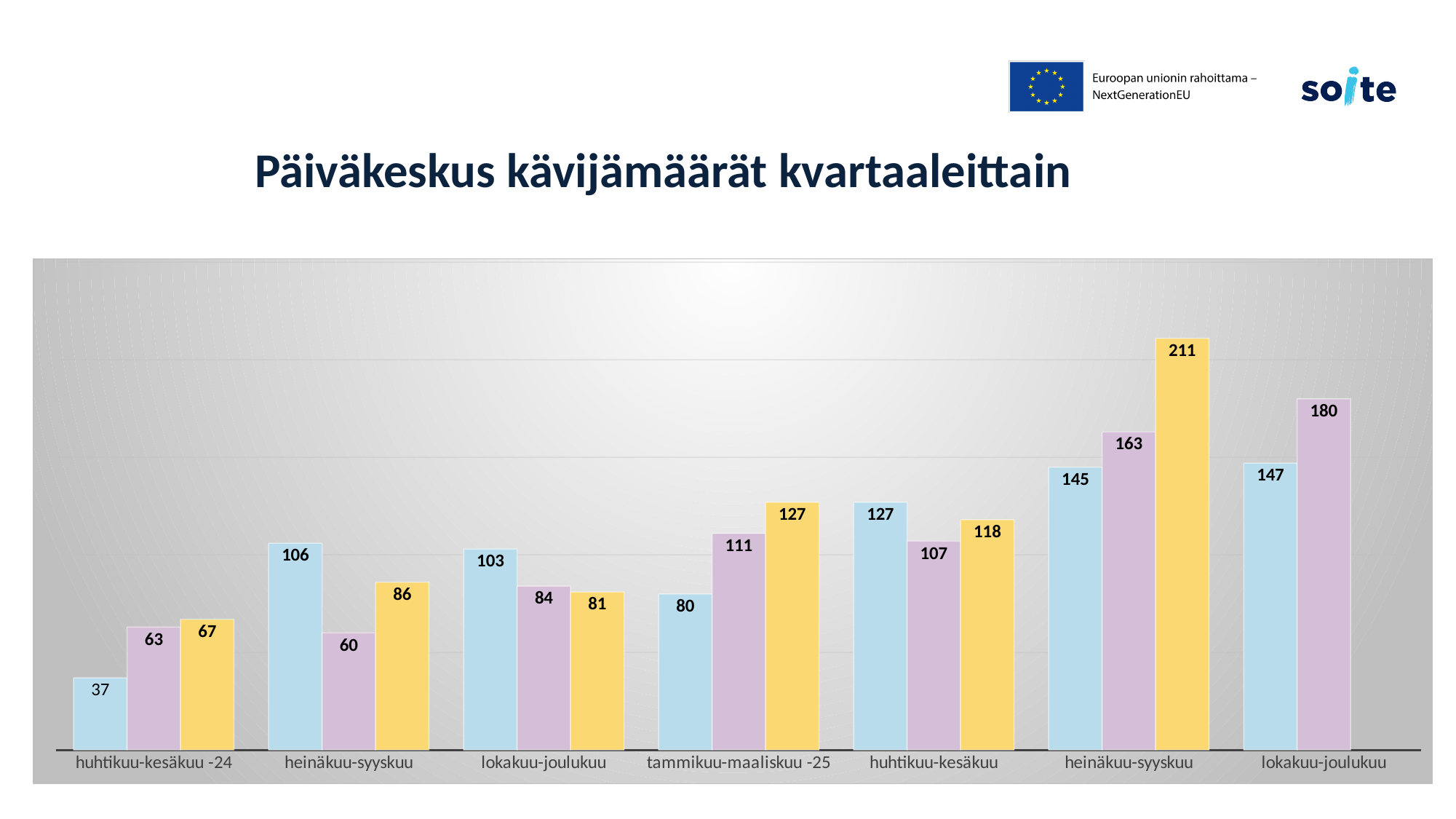
What is the lowest value shown in the chart? 37 What is the value of the purple bar for the second heinäkuu-syyskuu category (the one after huhtikuu-kesäkuu 2025)? 163 How many quarter categories are shown along the x axis? 7 What is the value of the yellow bar for tammikuu-maaliskuu -25? 127 What is the value of the light blue bar for huhtikuu-kesäkuu -24? 37 What kind of chart is shown on the slide? bar chart In the first heinäkuu-syyskuu category, which is larger: the light blue bar or the yellow bar? the light blue bar What is the total of the three bars for tammikuu-maaliskuu -25? 318 What is the title of the chart? Päiväkeskus kävijämäärät kvartaaleittain In the last lokakuu-joulukuu category, how much larger is the purple bar than the light blue bar? 33 What is the highest value shown in the chart? 211